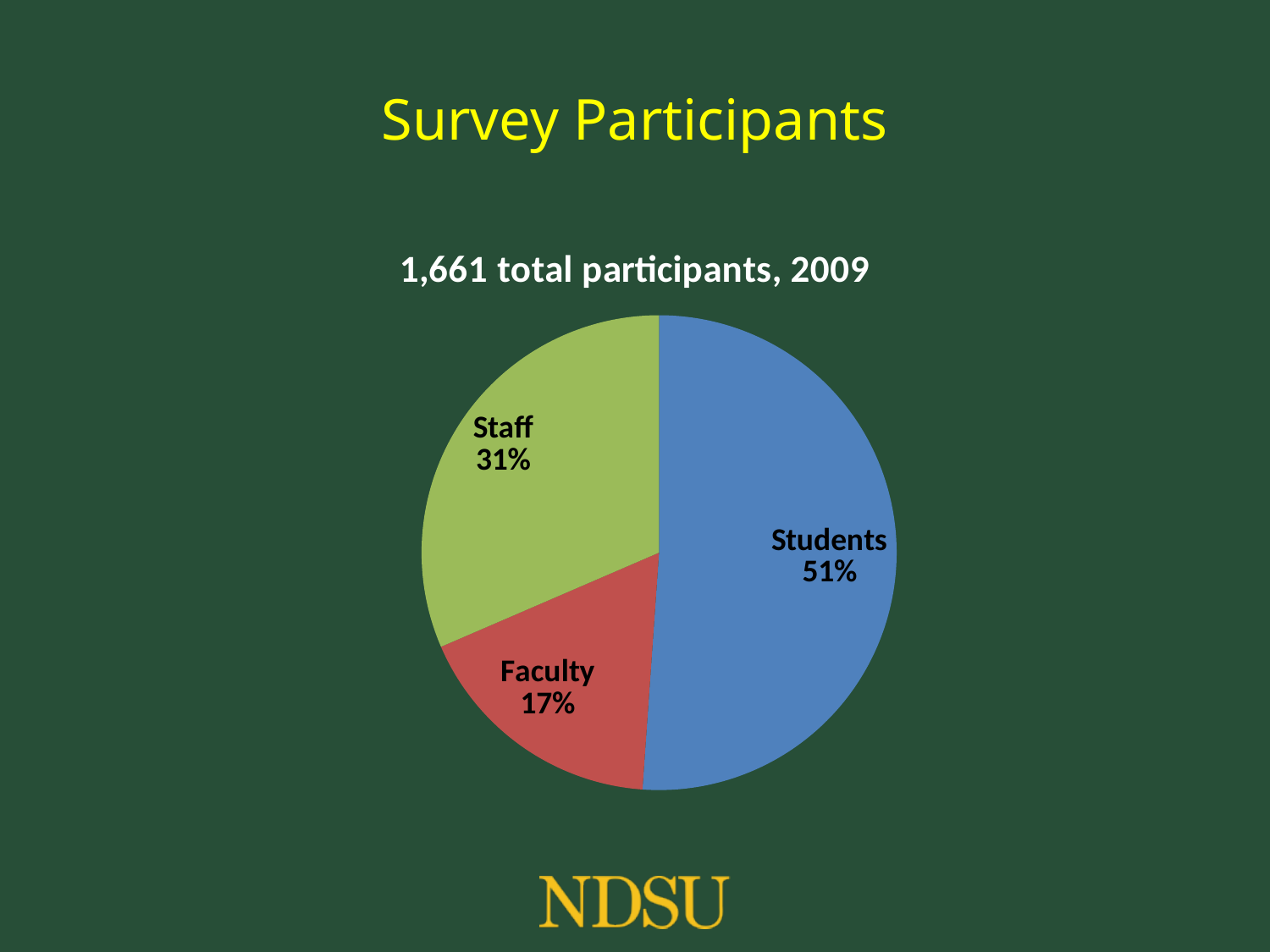
How many slices does the pie chart have? 3 Which group has the largest share of the pie? Students Which group has the smallest share of the pie? Faculty What is the chart's title? 1,661 total participants, 2009 What share of survey participants are Students? 51% What is the difference in percentage points between the Staff and Faculty shares? 14 What share of survey participants are Staff? 31% What share of survey participants are Faculty? 17% Which is larger, the Staff share or the Faculty share? Staff What is the difference in percentage points between the Students and Staff shares? 20 What kind of chart is shown on the slide? pie chart What colour is the Students slice? blue